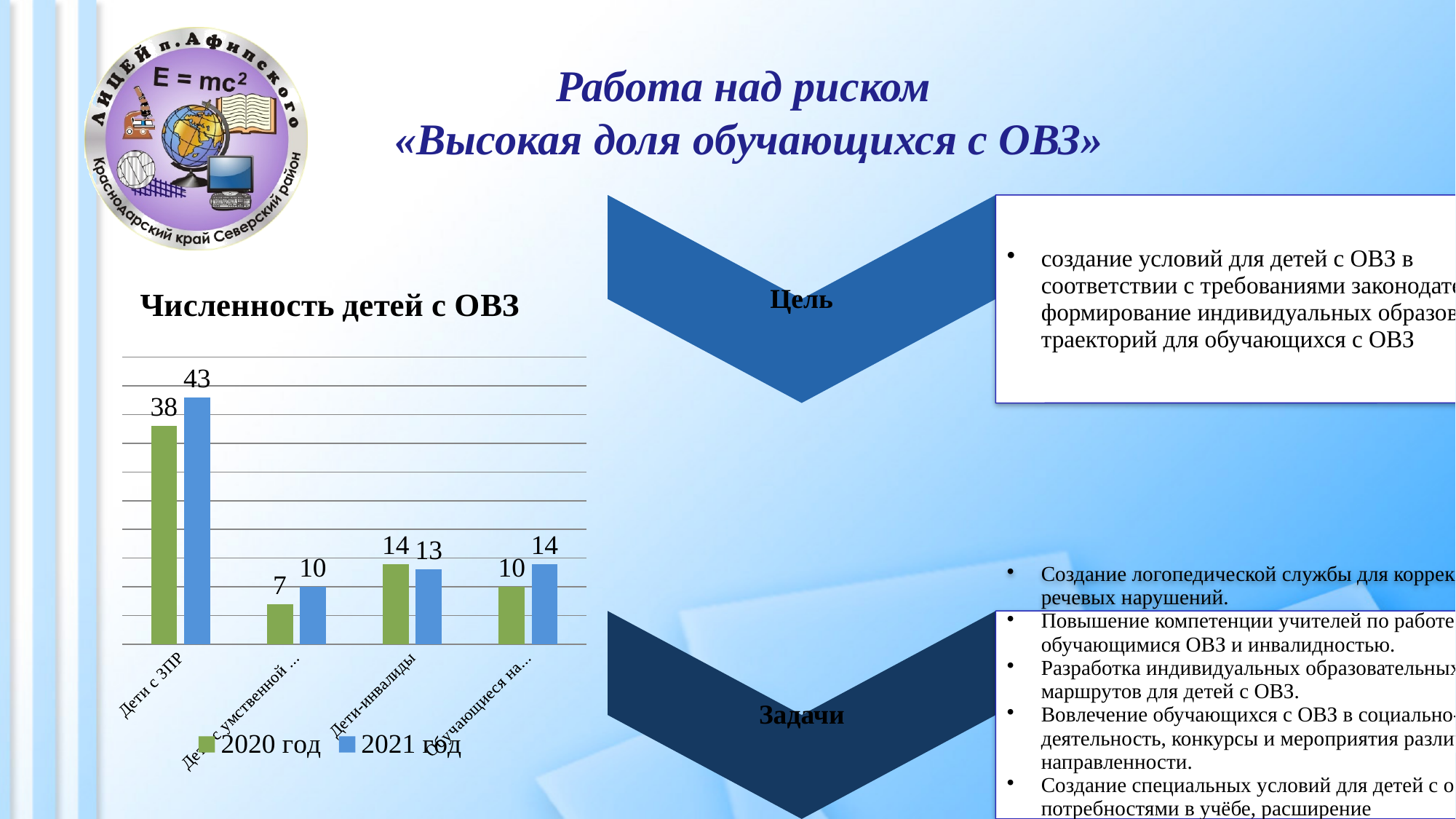
How many categories are shown on the x axis of the chart? 4 Which category has the lowest value in the 2020 год series? the second category from the left (Дети с умственной ...) Which category has the highest value in the 2021 год series? Дети с ЗПР What is the value for Дети с ЗПР in 2020 год? 38 For Дети-инвалиды, which series has the larger value, 2020 год or 2021 год? 2020 год How many series does the chart legend list? 2 What is the difference between the 2021 год and 2020 год values for Дети с ЗПР? 5 What is the value for Дети с ЗПР in 2021 год? 43 What are the two series named in the chart legend? 2020 год and 2021 год What type of chart is shown on the slide? bar chart What is the value for Дети-инвалиды in 2021 год? 13 What is the title of the chart on the slide? Численность детей с ОВЗ